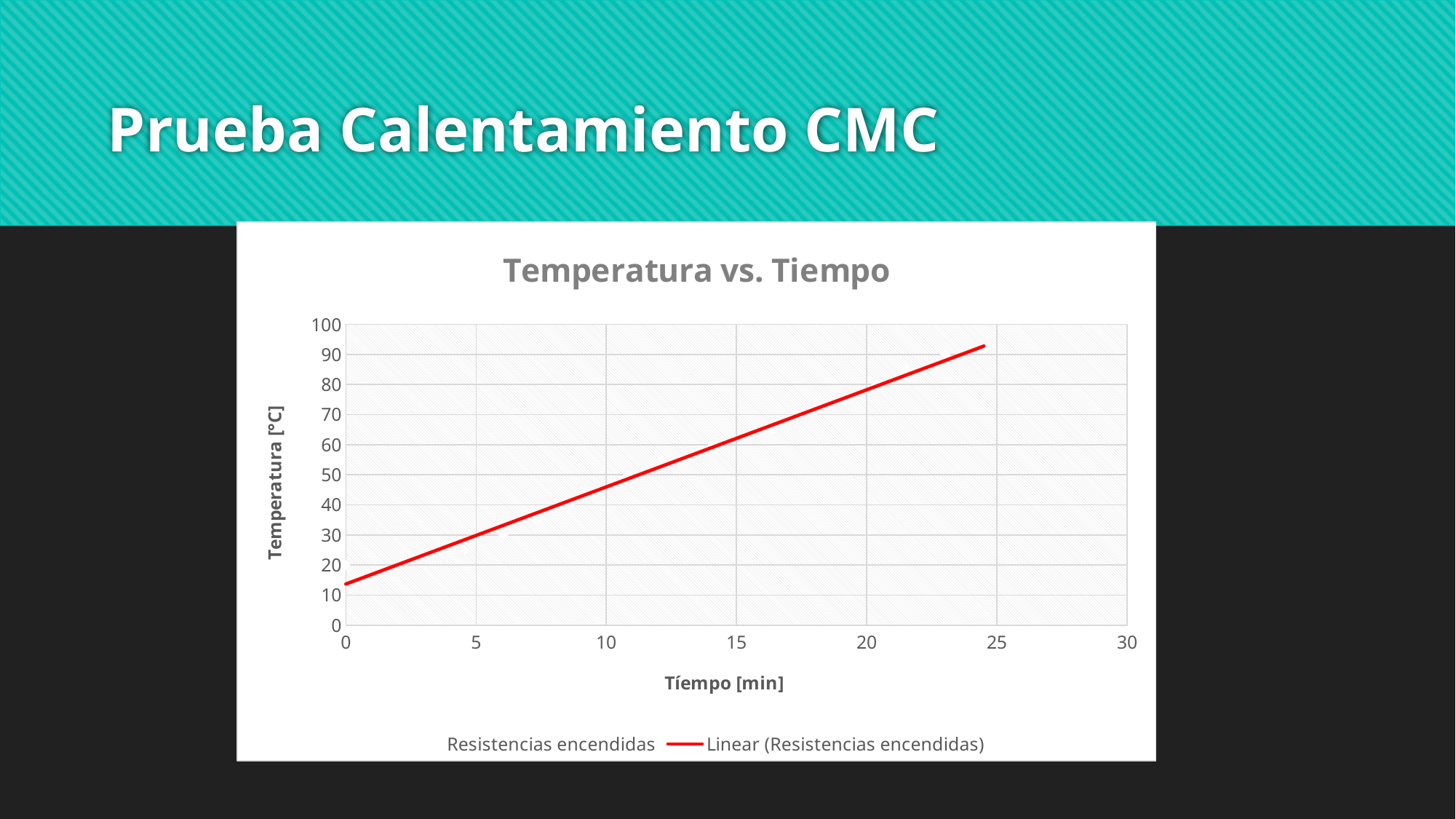
What is the label of the y axis? Temperatura [°C] Is the temperature on the trendline at 0 minutes greater or less than 20? less Is the temperature on the trendline at 20 minutes greater or less than 70? greater What kind of chart is shown on the slide? line chart Is the temperature on the trendline at 10 minutes greater or less than 40? greater What is the title of the chart? Temperatura vs. Tiempo How many entries does the chart legend list? 2 Does the temperature rise or fall as time increases along the x axis? rise